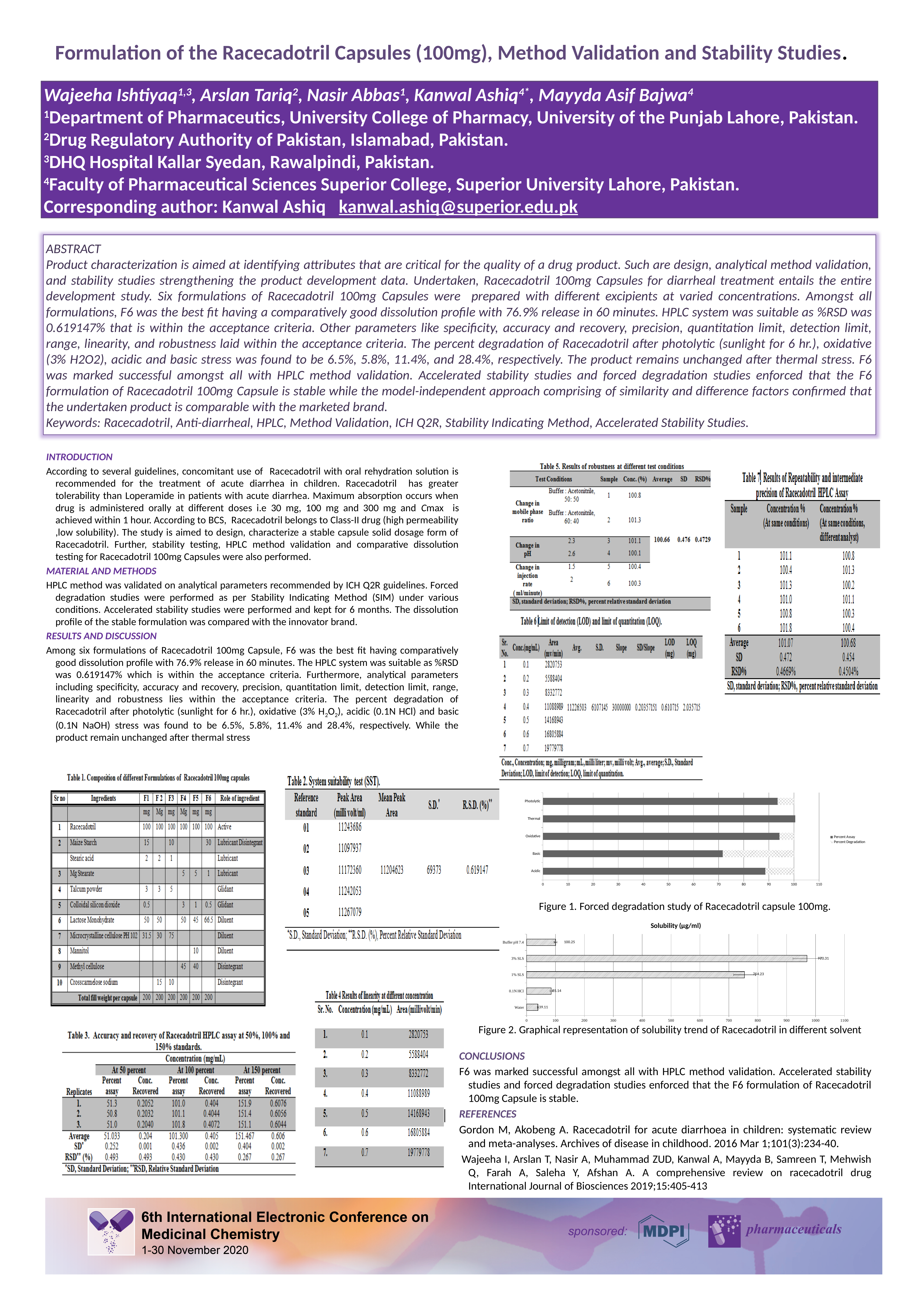
In Figure 1 (Forced degradation study), how many series does the legend list? 2 In Figure 2 (Solubility), which solvent has the highest solubility? 3% SLS In Figure 1 (Forced degradation study), is the Percent Assay value for Basic greater or less than 80? less In Figure 2 (Solubility), which has the larger solubility value, Buffer pH 7.4 or 0.1N HCl? Buffer pH 7.4 In Figure 1 (Forced degradation study), which stress condition has the highest Percent Assay? Thermal What kind of chart is Figure 2, the solubility chart? bar chart In Figure 2 (Solubility), what is the difference between the solubility in 3% SLS and in 1% SLS? 216.08 In Figure 2 (Solubility), what is the solubility value for Water? 39.11 In Figure 1 (Forced degradation study), how many stress conditions are plotted? 5 In Figure 2 (Solubility), which solvent has the lowest solubility? Water In Figure 2 (Solubility), what is the solubility value for 3% SLS? 970.31 In Figure 2 (Solubility), how many solvents are plotted? 5